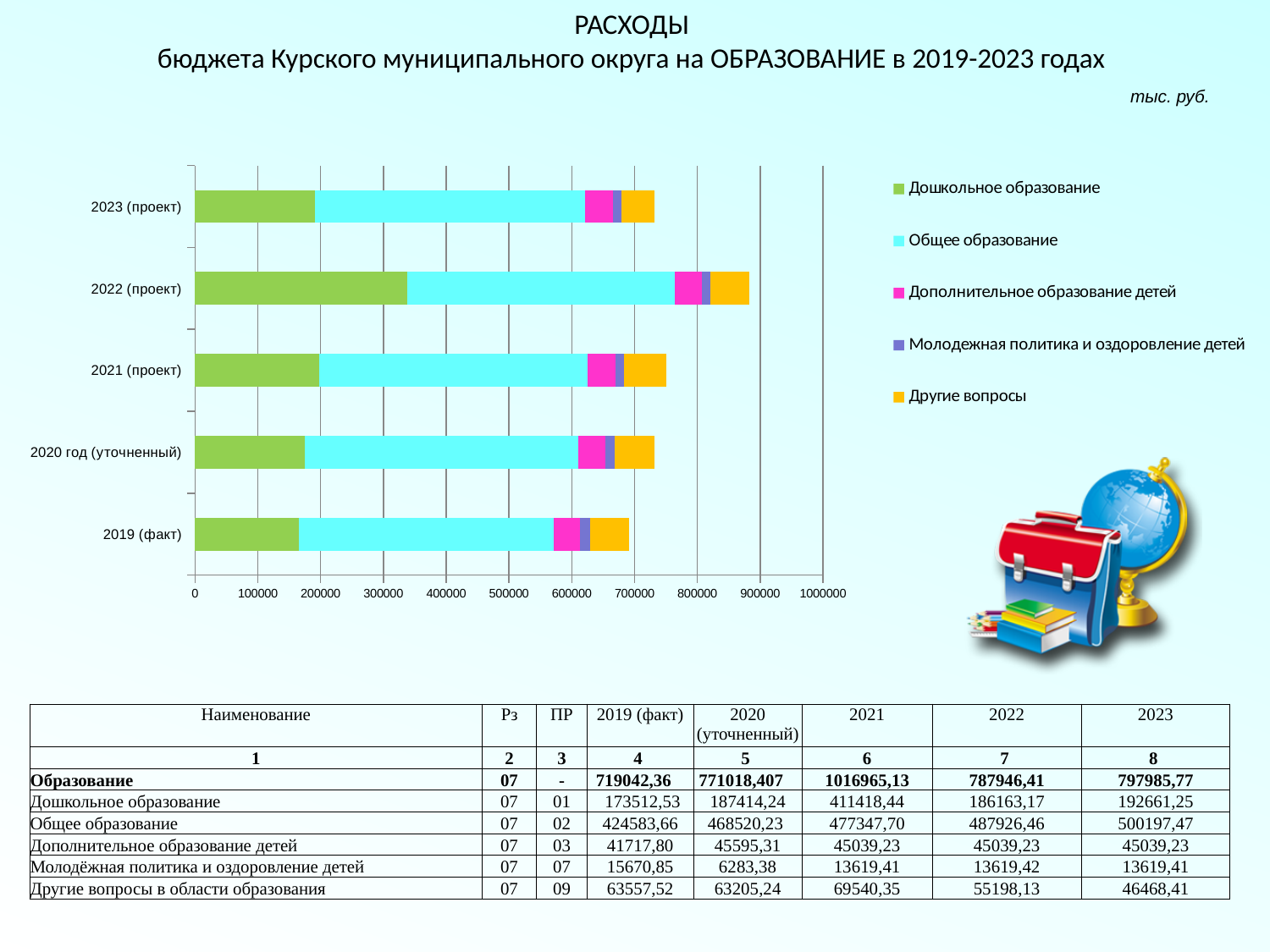
Is the Дошкольное образование segment for 2022 (проект) greater or less than 300000? greater Which legend entry is shown in yellow/orange? Другие вопросы How many series does the chart legend list? 5 Which year has the shortest total bar on the chart? 2019 (факт) Which is larger on the chart: the Дошкольное образование segment for 2022 (проект) or for 2023 (проект)? 2022 (проект) What kind of chart is shown on the slide? Stacked bar chart Is the total bar for 2022 (проект) greater or less than 800000? greater Which colour represents Общее образование in the chart legend? Light blue (cyan) How many year categories are plotted on the chart? 5 Which year has the longest total bar on the chart? 2022 (проект)